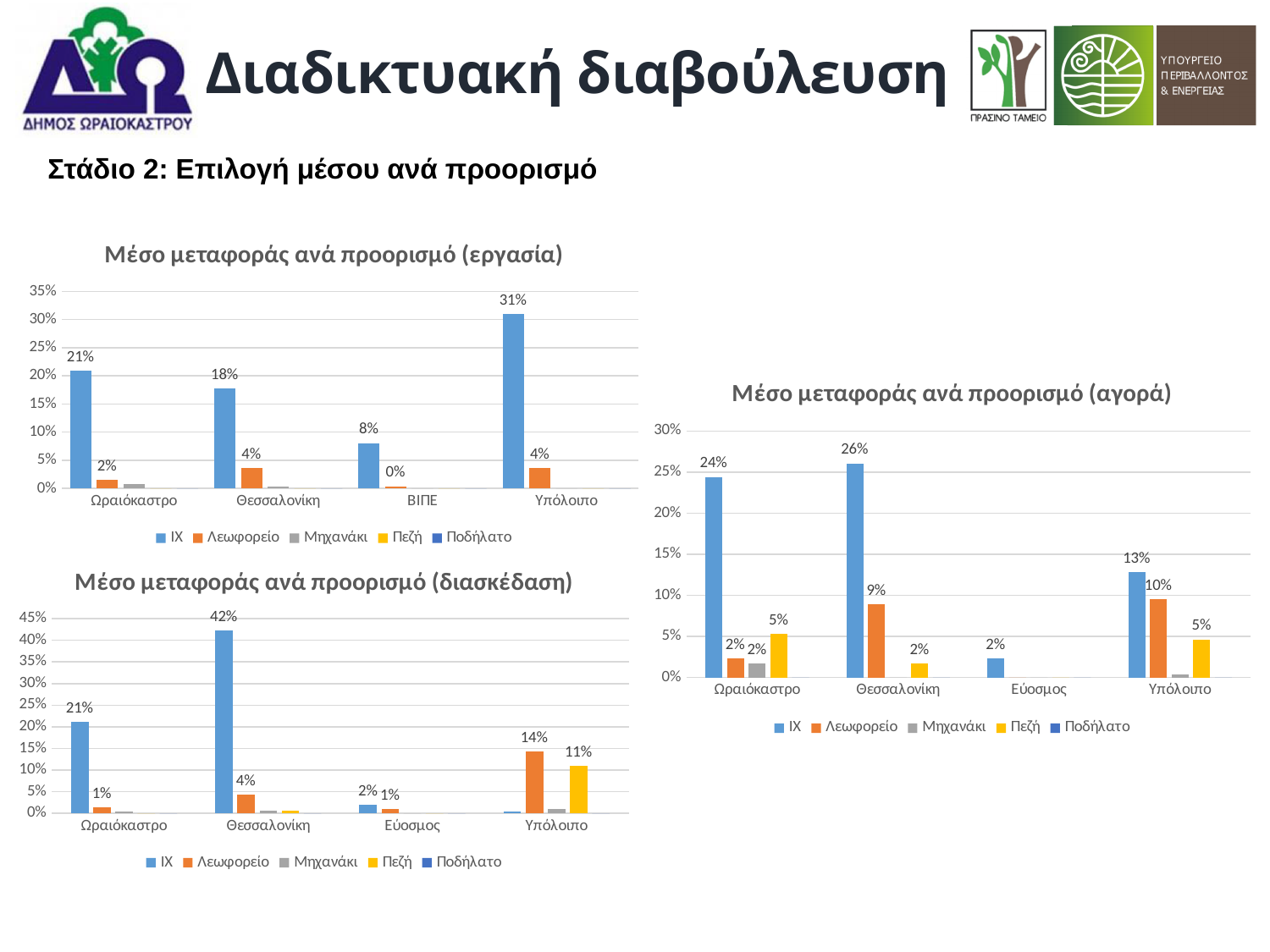
In the chart 'Μέσο μεταφοράς ανά προορισμό (εργασία)', which category has the highest ΙΧ value? Υπόλοιπο In the chart 'Μέσο μεταφοράς ανά προορισμό (αγορά)', what is the Λεωφορείο value for Θεσσαλονίκη? 9% In the chart 'Μέσο μεταφοράς ανά προορισμό (αγορά)', what is the difference between the ΙΧ and Λεωφορείο values for Υπόλοιπο? 3% In the chart 'Μέσο μεταφοράς ανά προορισμό (αγορά)', which is larger: the ΙΧ value for Ωραιόκαστρο or for Θεσσαλονίκη? Θεσσαλονίκη In the chart 'Μέσο μεταφοράς ανά προορισμό (διασκέδαση)', what is the Πεζή value for Υπόλοιπο? 11% In the chart 'Μέσο μεταφοράς ανά προορισμό (εργασία)', what is the difference between the ΙΧ values for Ωραιόκαστρο and ΒΙΠΕ? 13% How many series does the legend of the chart 'Μέσο μεταφοράς ανά προορισμό (αγορά)' list? 5 In the chart 'Μέσο μεταφοράς ανά προορισμό (εργασία)', what is the Λεωφορείο value for ΒΙΠΕ? 0% In the chart 'Μέσο μεταφοράς ανά προορισμό (διασκέδαση)', which category has the highest Λεωφορείο value? Υπόλοιπο In the chart 'Μέσο μεταφοράς ανά προορισμό (διασκέδαση)', what is the ΙΧ value for Θεσσαλονίκη? 42% What type of chart is 'Μέσο μεταφοράς ανά προορισμό (εργασία)'? Bar chart In the chart 'Μέσο μεταφοράς ανά προορισμό (εργασία)', what is the value for ΙΧ for Υπόλοιπο? 31%